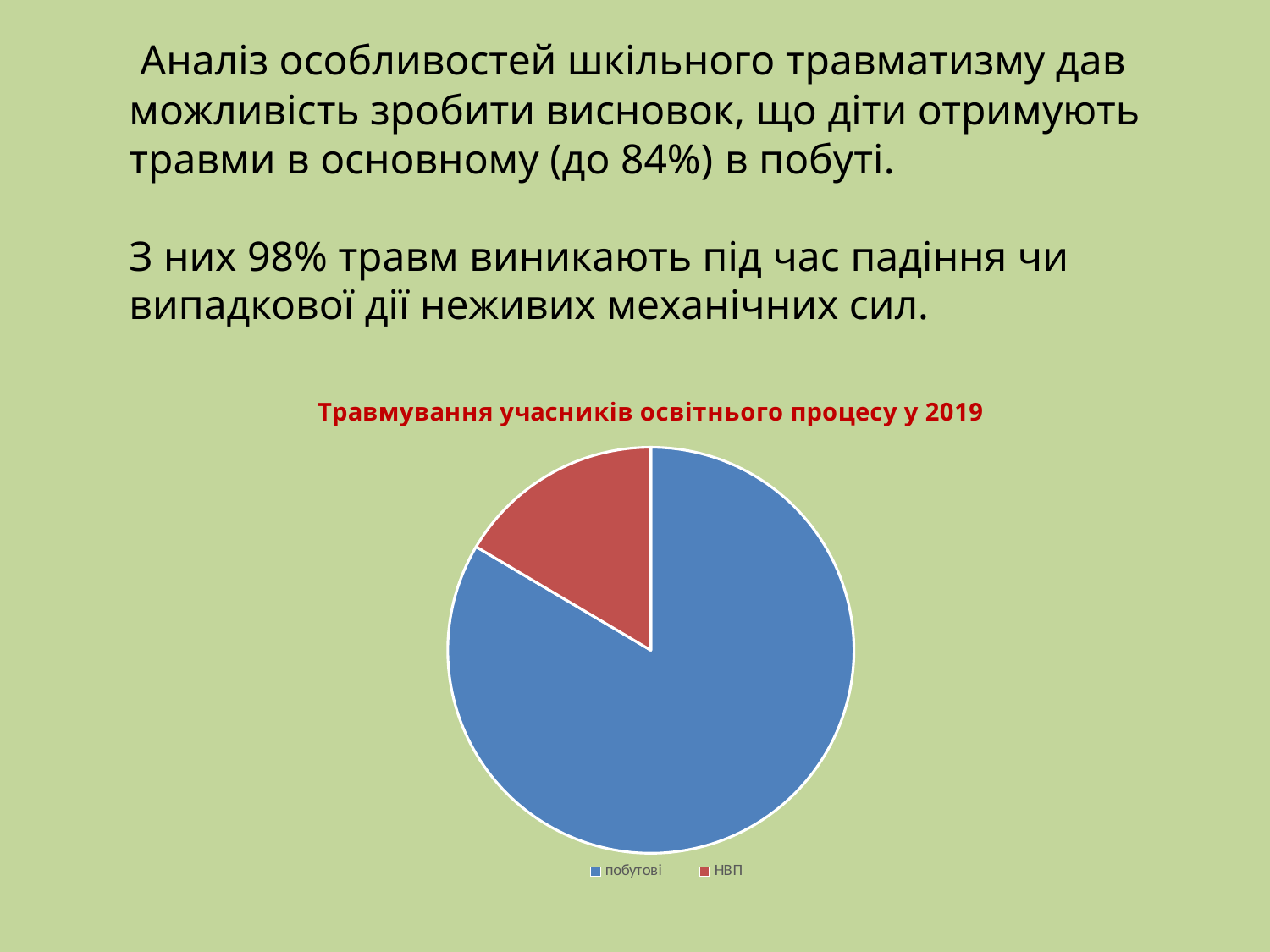
How many entries does the chart legend list? 2 Does the побутові slice take up more or less than half of the pie? more Which category has the largest slice of the pie? побутові What colour is the slice for НВП? red Which slice is larger, побутові or НВП? побутові How many slices does the pie chart have? 2 Which category has the smallest slice of the pie? НВП What is the title of the chart? Травмування учасників освітнього процесу у 2019 What kind of chart is shown on the slide? pie chart